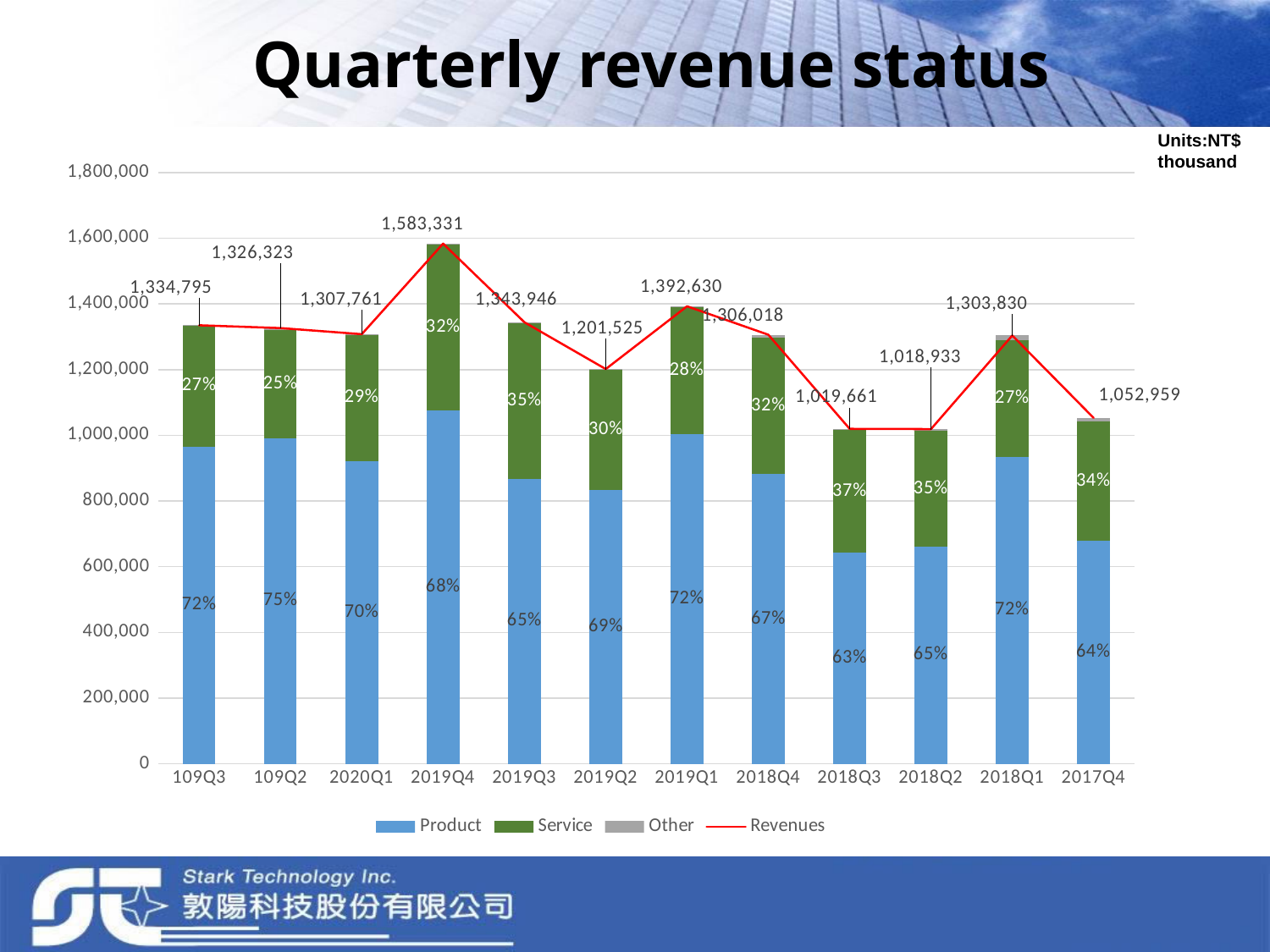
Which quarter has the lowest revenue? 2018Q2 Which quarter has higher revenue, 2019Q1 or 2018Q4? 2019Q1 What kind of chart is shown on the slide? Stacked bar chart with a line How many series does the legend list? 4 What percentage of revenue does Product account for in 109Q2? 75% What is the revenue for 2018Q2? 1,018,933 What percentage of revenue does Service account for in 2018Q3? 37% How many quarters are shown on the x axis? 12 Is the Product value for 2018Q3 greater or less than 800,000? less What is the revenue for 2019Q4? 1,583,331 What is the difference in revenue between 2019Q4 and 2019Q2? 381,806 Which quarter has the highest revenue? 2019Q4